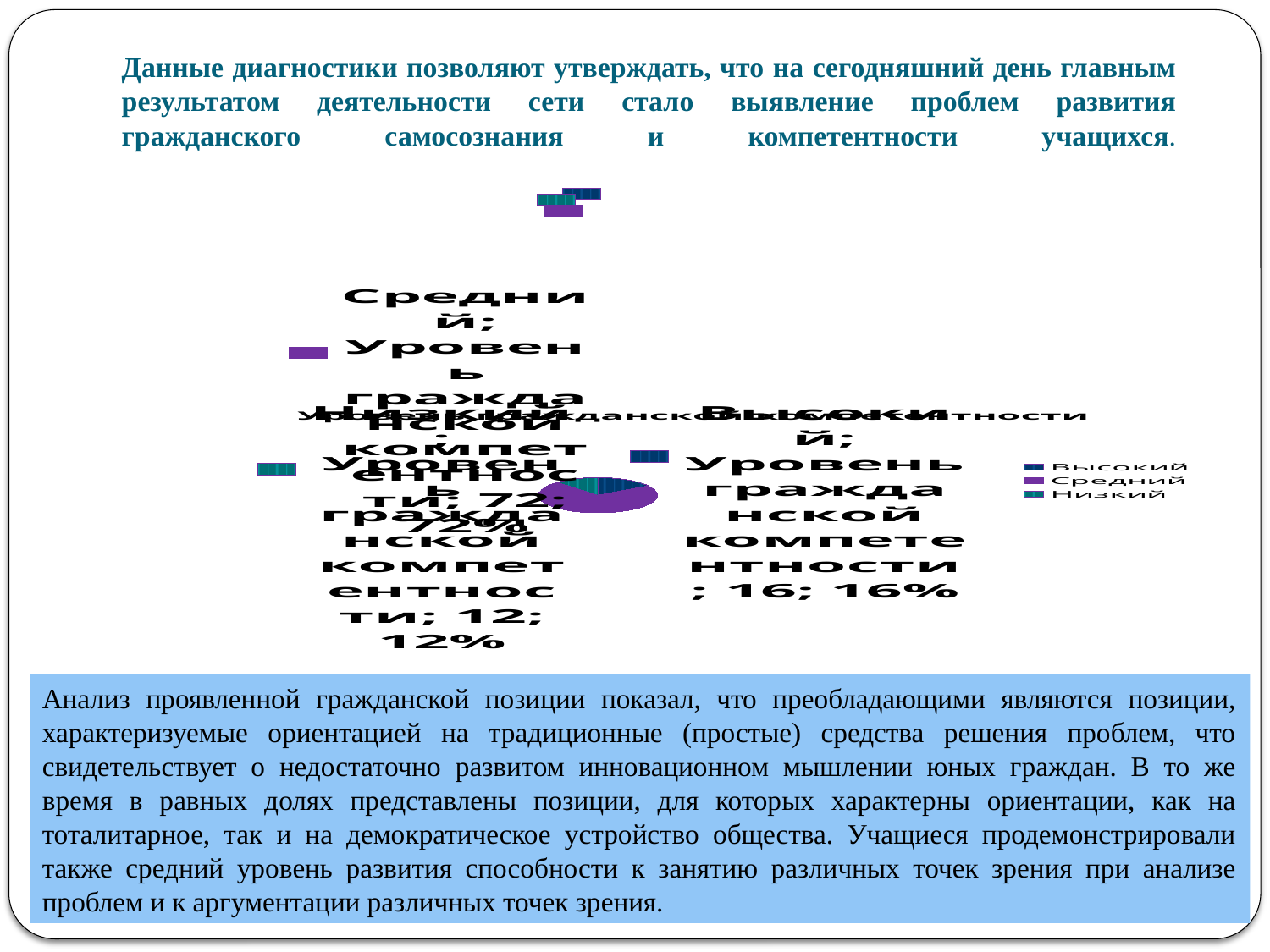
Which colour represents Средний in the pie chart legend? purple What percentage of the pie chart is the Высокий (high) level of civic competence? 16% What percentage of the pie chart is the Средний (medium) level of civic competence? 72% Which slice is larger, Высокий or Низкий? Высокий What value is shown for the Средний slice of the pie chart? 72 What is the difference in percentage points between the Средний and Высокий slices? 56 How many slices does the pie chart have? 3 Which level has the smallest share of the pie chart? Низкий Which level has the largest share of the pie chart? Средний What percentage of the pie chart is the Низкий (low) level of civic competence? 12% What kind of chart is shown on the slide? pie chart How many entries does the legend of the pie chart list? 3